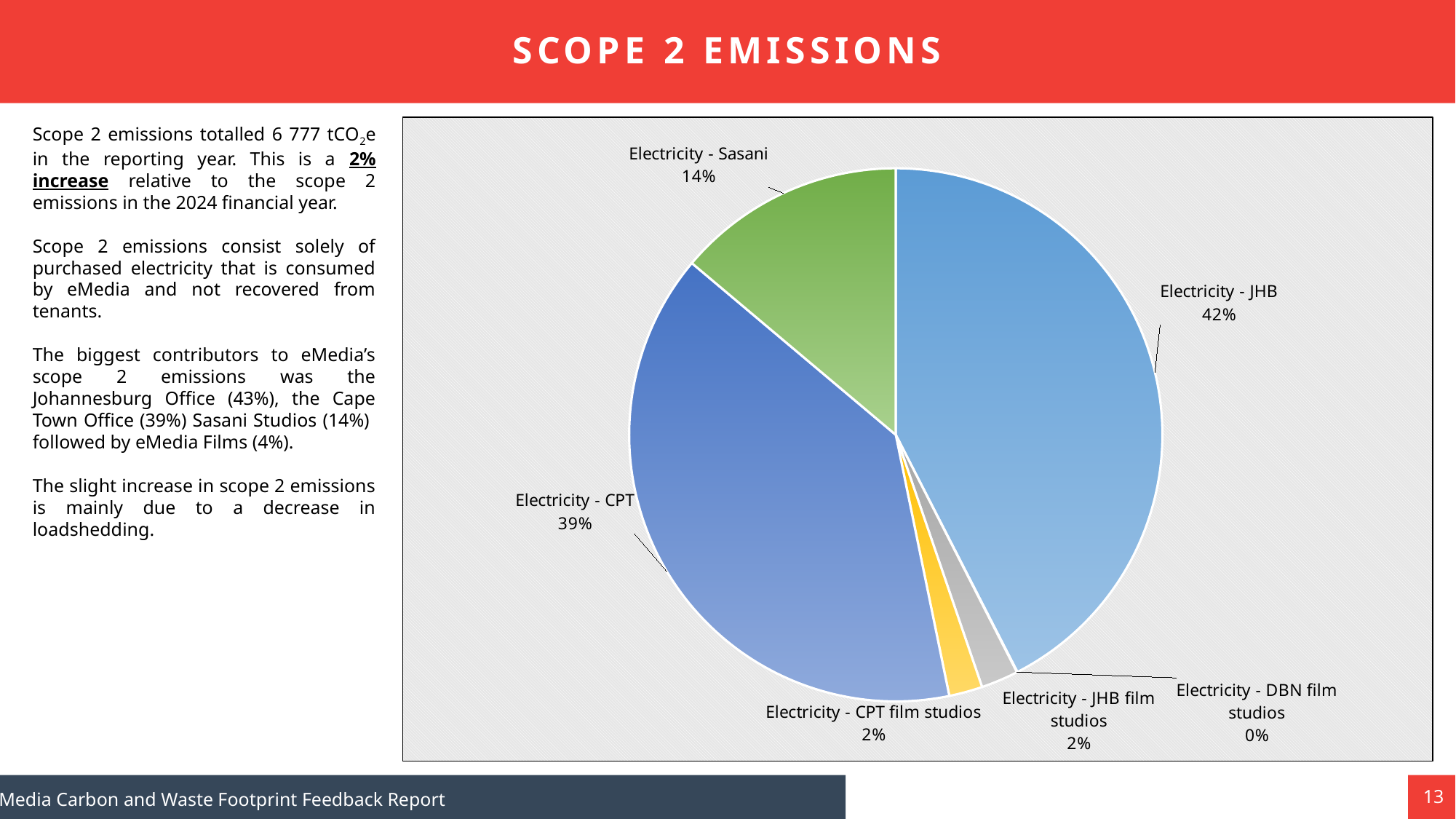
What colour is the Electricity - Sasani slice? green What kind of chart is shown on the slide? pie chart Which category has the smallest slice of the pie? Electricity - DBN film studios What is the value shown for Electricity - CPT? 39% What is the value shown for Electricity - CPT film studios? 2% What is the difference in percentage points between Electricity - JHB and Electricity - CPT? 3 What share of the pie does Electricity - JHB account for? 42% What is the value shown for Electricity - DBN film studios? 0% Which is larger, the share for Electricity - JHB or Electricity - CPT? Electricity - JHB How many categories are shown in the pie chart? 6 Which category has the largest slice of the pie? Electricity - JHB What is the value shown for Electricity - Sasani? 14%